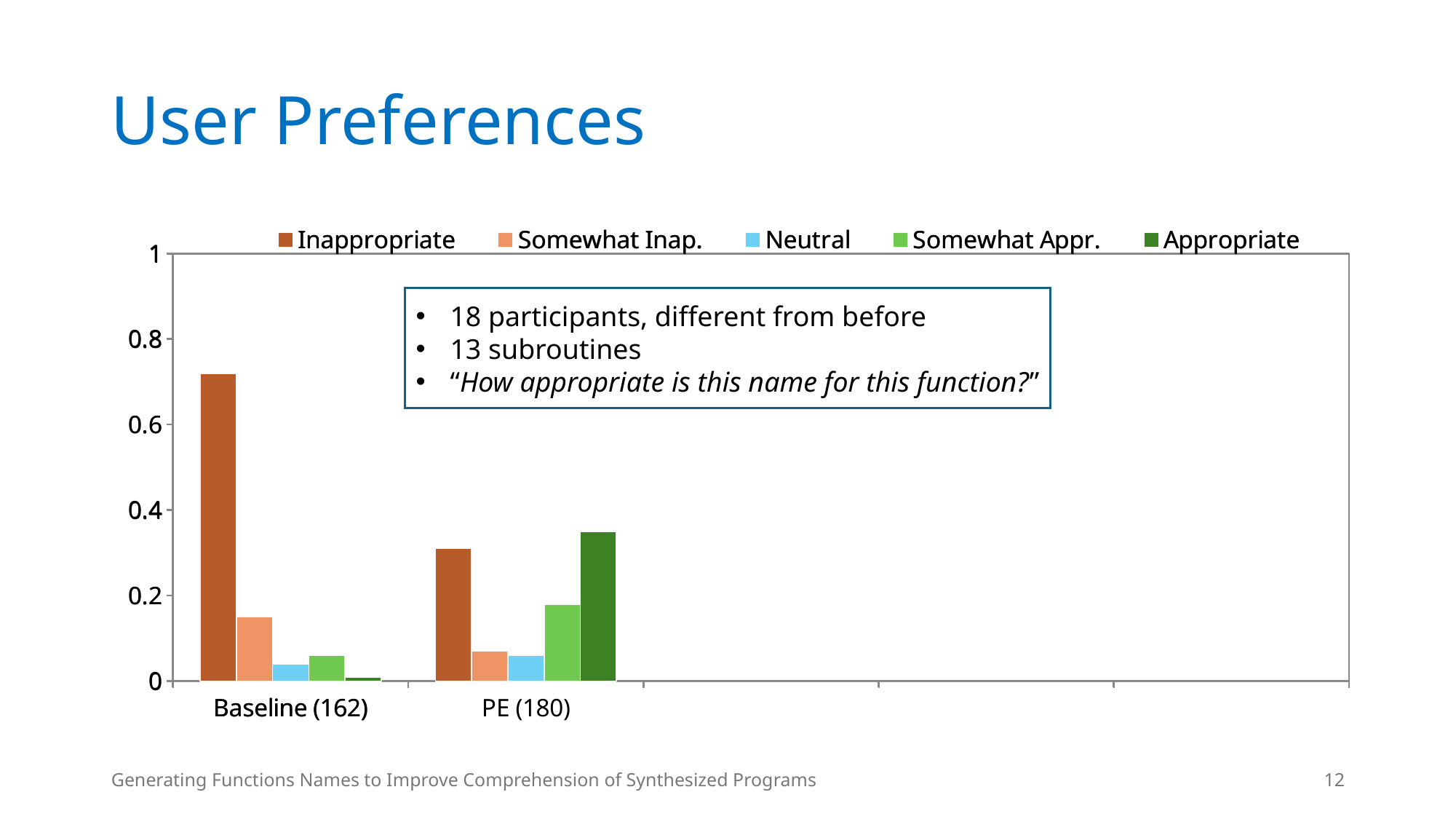
How many categories are shown on the x axis of the chart? 2 Which series has the lowest value for Baseline (162)? Appropriate Is the Inappropriate value for PE (180) greater or less than 0.2? greater Which category has the larger Somewhat Appr. value, Baseline (162) or PE (180)? PE (180) Which series has the highest value for Baseline (162)? Inappropriate Which category has the larger Inappropriate value, Baseline (162) or PE (180)? Baseline (162) How many series does the chart's legend list? 5 Is the Appropriate value for PE (180) greater or less than 0.4? less What is the title of the slide containing the chart? User Preferences What kind of chart is shown on the slide? bar chart Which series has the lowest value for PE (180)? Neutral Is the Inappropriate value for Baseline (162) greater or less than 0.6? greater